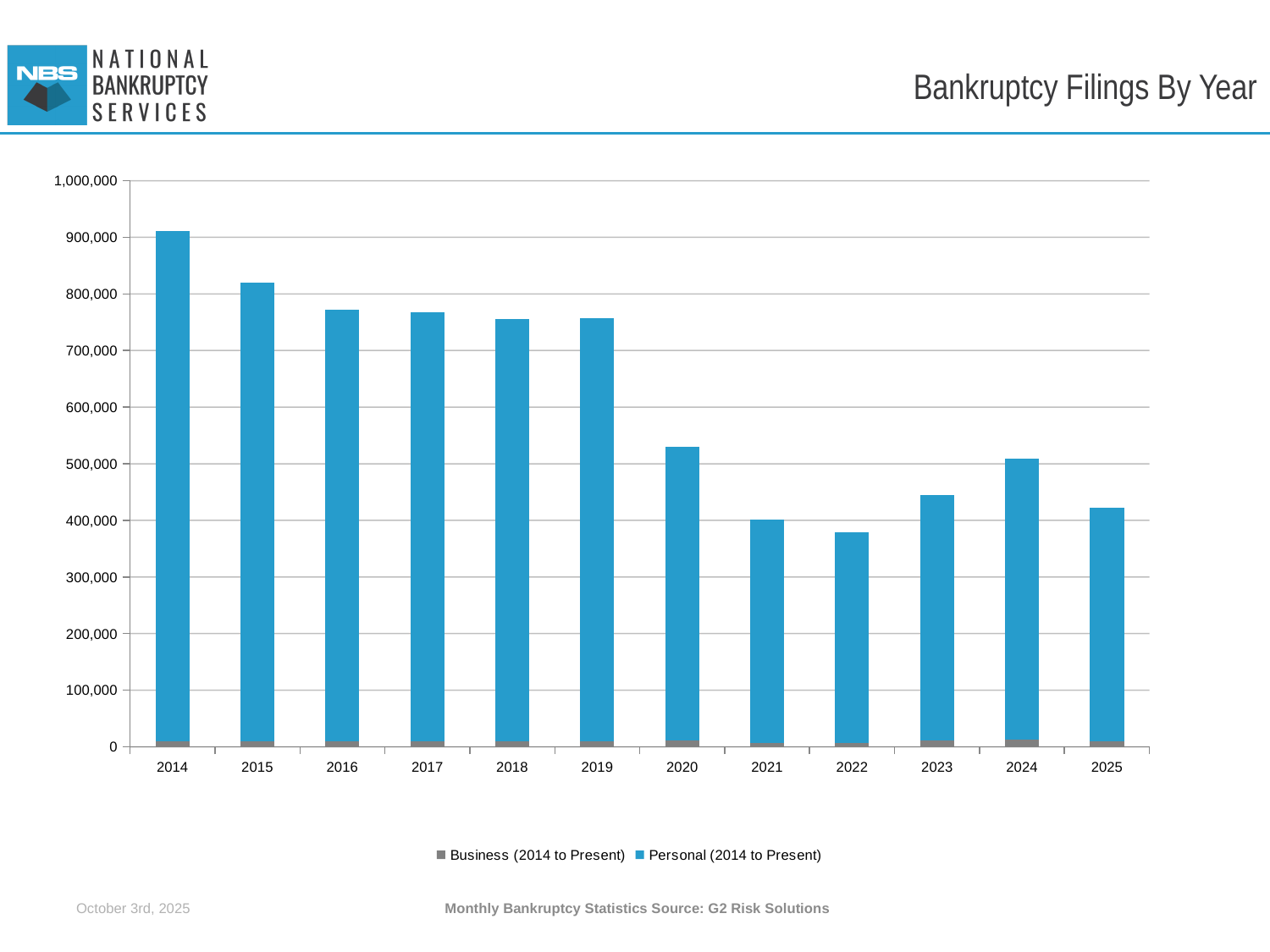
Which year has the larger total, 2014 or 2015? 2014 How many series does the legend list? 2 Do the total filings rise or fall from 2014 to 2019? fall Is the total value for 2022 greater or less than 400,000? less Which year has the highest total bankruptcy filings? 2014 How many years are shown on the x axis of the chart? 12 Which year has the larger total, 2023 or 2024? 2024 What kind of chart is shown on the slide? Bar chart What is the title of the chart? Bankruptcy Filings By Year Is the total value for 2023 greater or less than 500,000? less Is the total value for 2020 greater or less than 500,000? greater